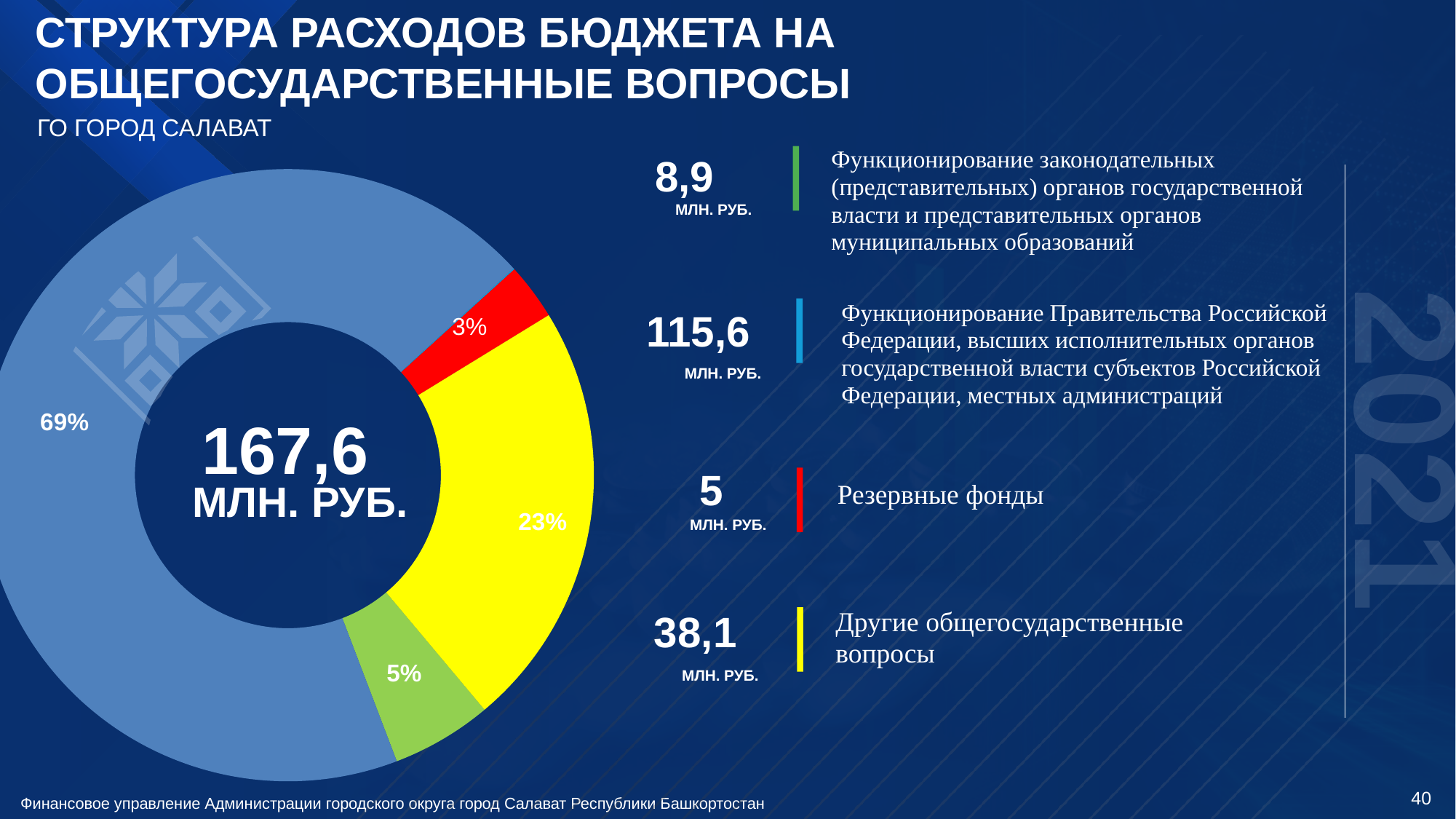
What is the value for Резервные фонды? 5 млн. руб. Which category has the smallest share of the donut chart? Резервные фонды Which category has the largest share of the donut chart? Функционирование Правительства Российской Федерации, высших исполнительных органов государственной власти субъектов Российской Федерации, местных администраций What share of the donut chart does the blue slice (Функционирование Правительства Российской Федерации...) represent? 69% What share of the donut chart does the green slice (Функционирование законодательных (представительных) органов...) represent? 5% What is the difference in млн. руб. between Другие общегосударственные вопросы (38,1) and Функционирование законодательных органов (8,9)? 29,2 млн. руб. How many slices does the donut chart have? 4 What kind of chart is shown on the slide? Pie (donut) chart What total value is shown in the centre of the donut chart? 167,6 млн. руб. What share of the donut chart does the red slice (Резервные фонды) represent? 3% What is the value for Другие общегосударственные вопросы? 38,1 млн. руб.